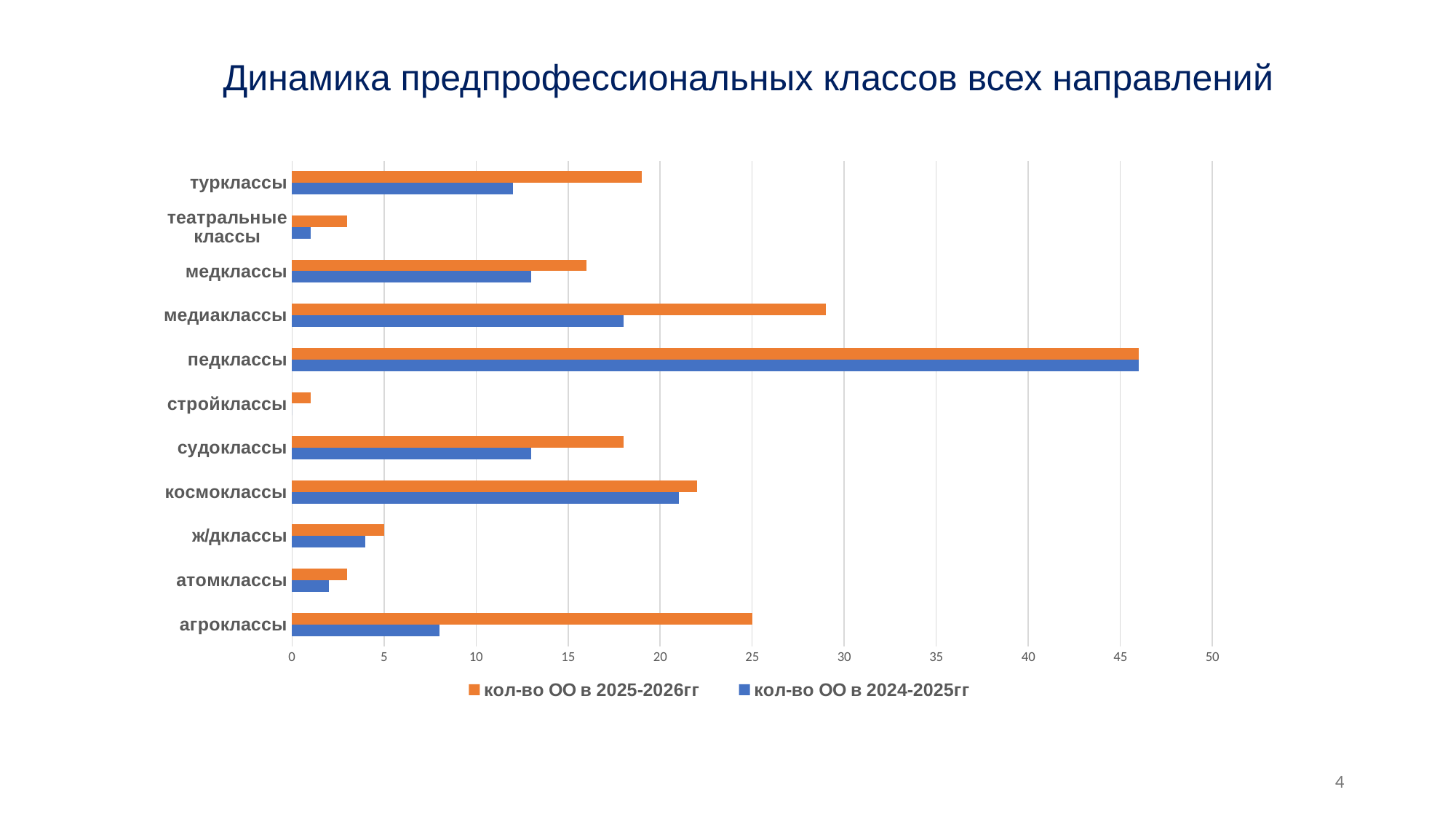
Is the value for педклассы in the series кол-во ОО в 2024-2025гг greater or less than 45? greater Which category has the highest value in the series кол-во ОО в 2025-2026гг? педклассы Is the value for медиаклассы in the series кол-во ОО в 2025-2026гг greater or less than 25? greater How many categories are shown on the chart? 11 What is the value for ж/дклассы in the series кол-во ОО в 2025-2026гг? 5 For агроклассы, which series has the larger value: кол-во ОО в 2025-2026гг or кол-во ОО в 2024-2025гг? кол-во ОО в 2025-2026гг Which category has the lowest value in the series кол-во ОО в 2025-2026гг? стройклассы How many series does the legend list? 2 Is the value for агроклассы in the series кол-во ОО в 2024-2025гг greater or less than 10? less What is the title of the chart? Динамика предпрофессиональных классов всех направлений What is the value for агроклассы in the series кол-во ОО в 2025-2026гг? 25 What kind of chart is shown on the slide? bar chart